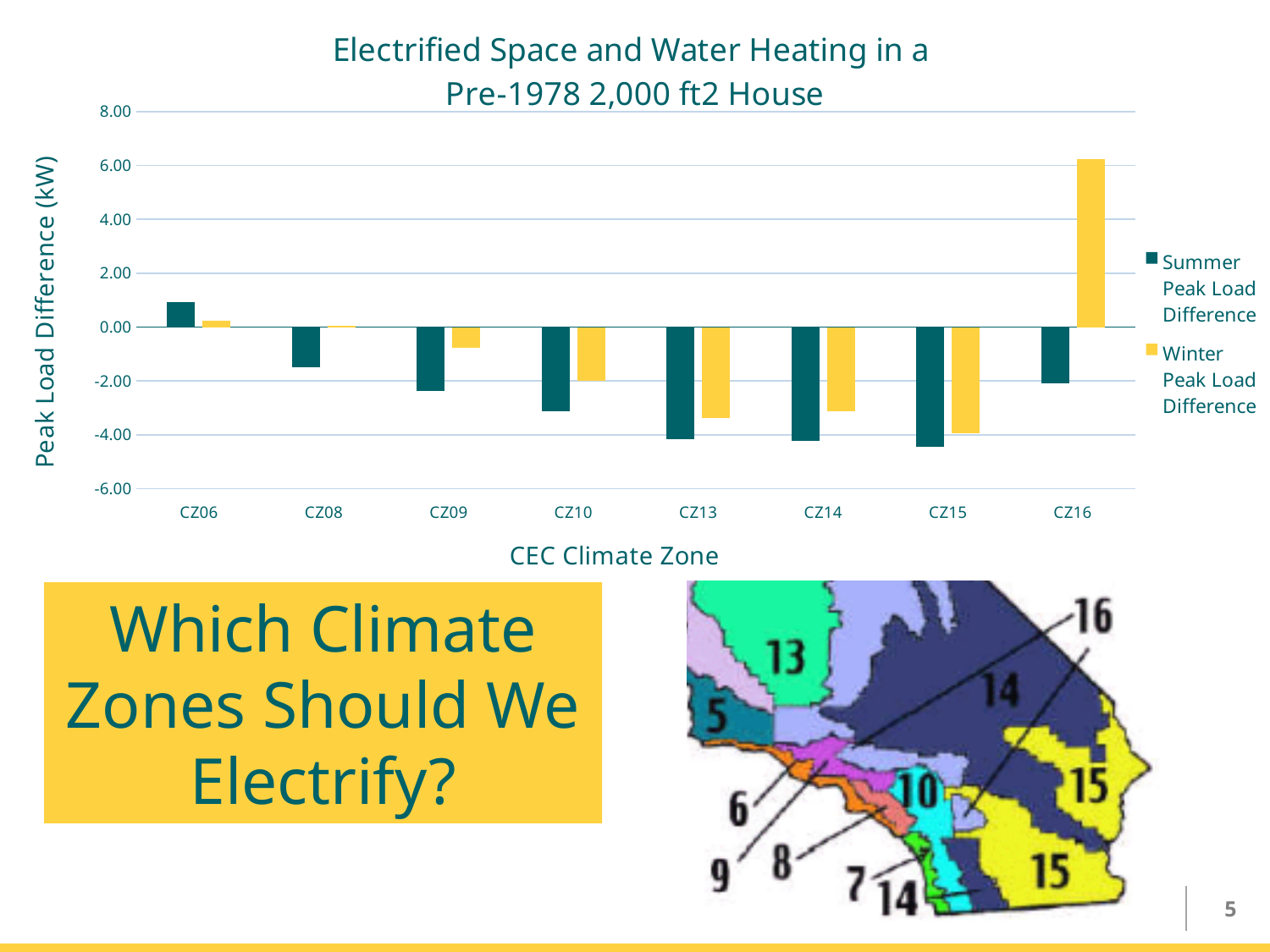
Which climate zone has the highest Summer Peak Load Difference? CZ06 How many climate zones are shown on the x axis of the chart? 8 Is the Winter Peak Load Difference for CZ13 greater or less than -2.00? less Which climate zone has the highest Winter Peak Load Difference? CZ16 For CZ16, which is larger: the Summer Peak Load Difference or the Winter Peak Load Difference? Winter Peak Load Difference Is the Winter Peak Load Difference for CZ16 greater or less than 4.00? greater Which climate zone has the lowest Winter Peak Load Difference? CZ15 Is the Summer Peak Load Difference for CZ09 greater or less than -2.00? less What kind of chart is shown on the slide? bar chart What colour are the Winter Peak Load Difference bars in the chart? yellow What is the label of the chart's y axis? Peak Load Difference (kW) How many series does the chart's legend list? 2